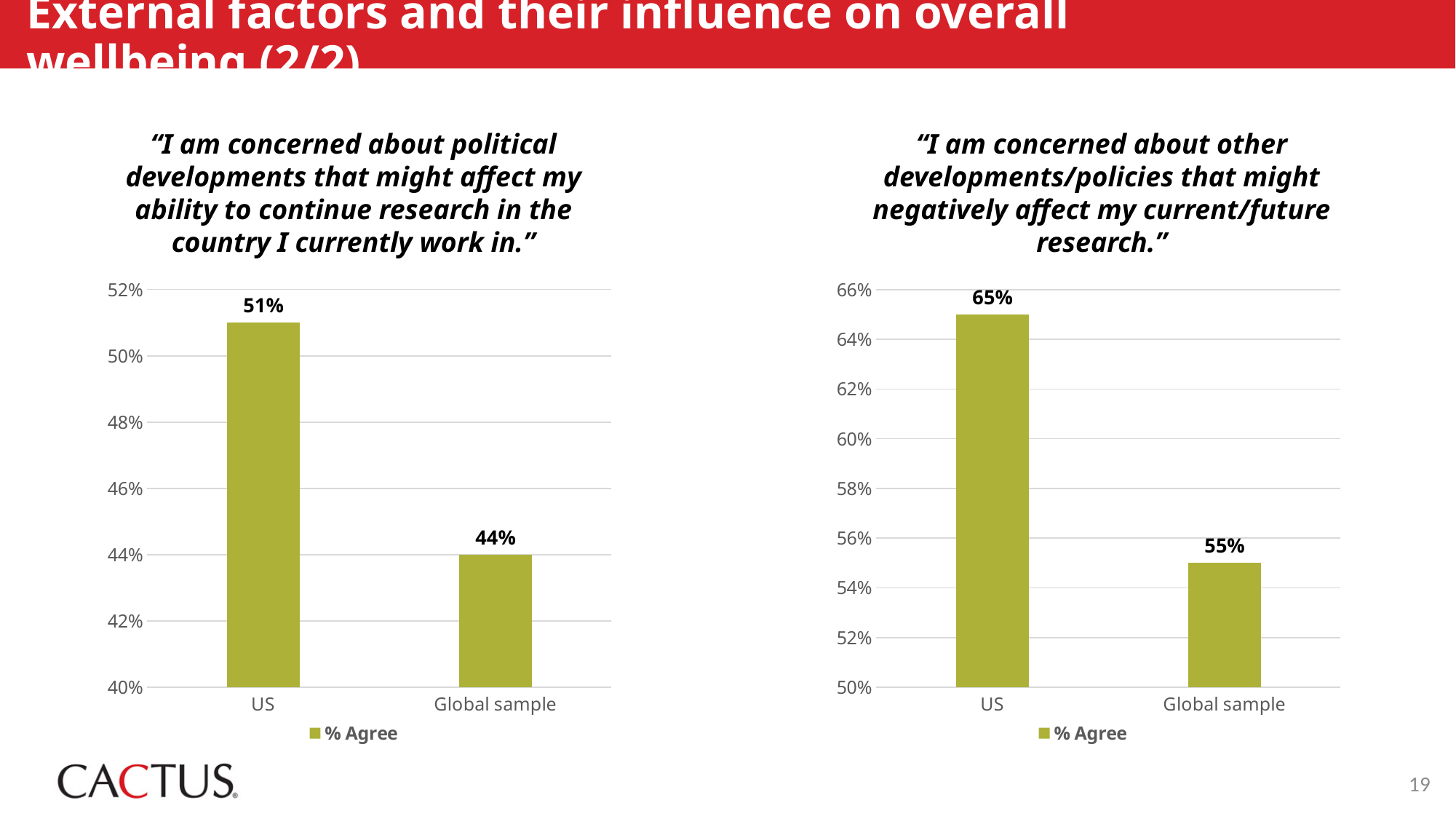
In the right chart (other developments/policies), what is the % Agree value for Global sample? 55% In the right chart (other developments/policies), what is the % Agree value for US? 65% How many categories are shown in the left chart (political developments)? 2 In the left chart (political developments), what is the % Agree value for Global sample? 44% In the right chart (other developments/policies), what is the difference in % Agree between US and Global sample? 10% In the right chart (other developments/policies), which category has the lowest % Agree? Global sample In the left chart (political developments), which category has the highest % Agree? US In the left chart (political developments), what is the difference in % Agree between US and Global sample? 7% In the left chart (political developments), what is the % Agree value for US? 51% How many series does the legend of the right chart (other developments/policies) list? 1 What kind of chart is the left chart (political developments)? Bar chart In the right chart (other developments/policies), which is larger, the % Agree for US or for Global sample? US